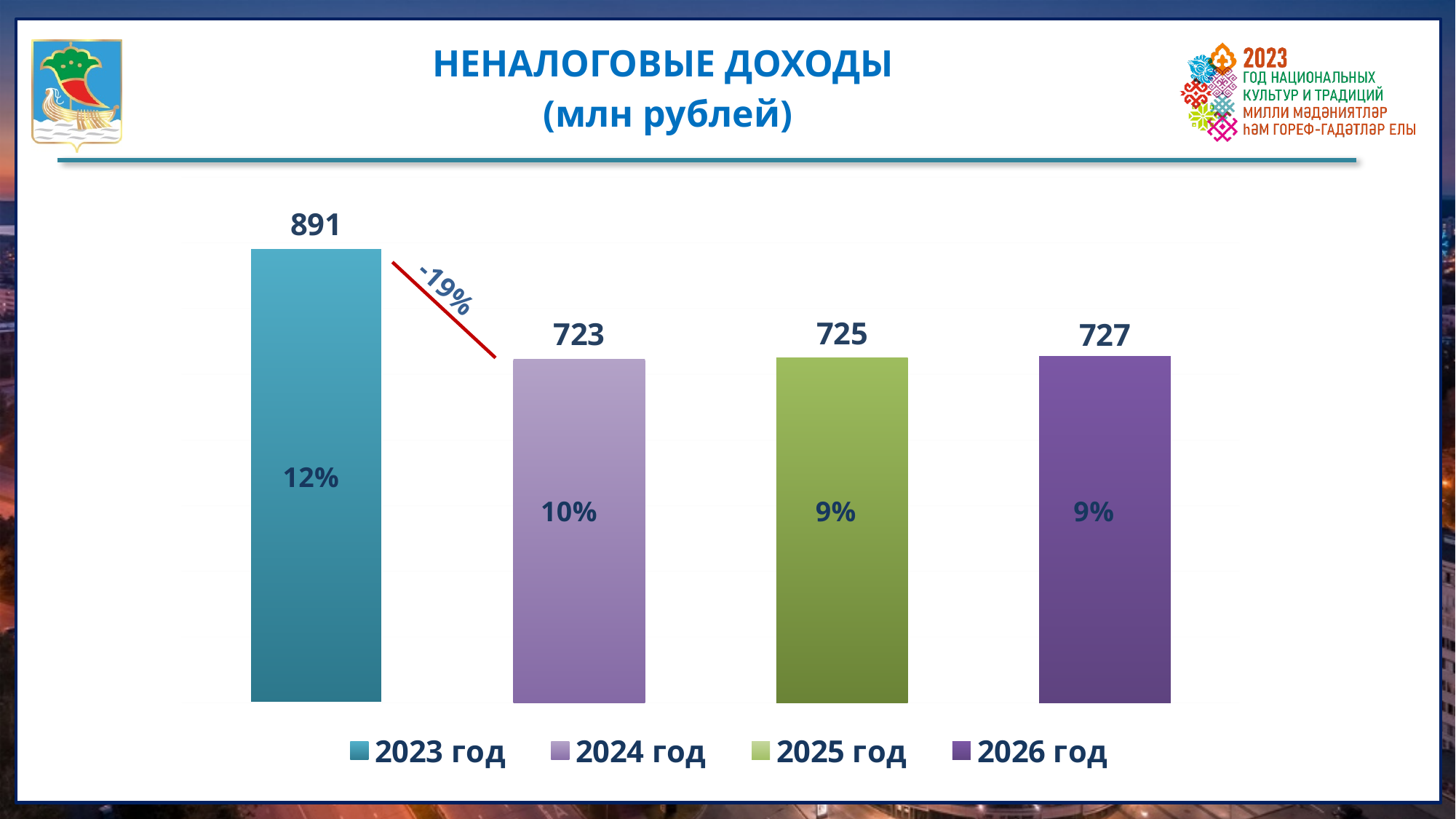
Which year has the lowest value? 2024 год What kind of chart is shown on the slide? Bar chart What percentage is shown inside the bar for 2025 год? 9% What is the value for 2023 год? 891 What is the value for 2024 год? 723 What is the difference between the values for 2026 год and 2025 год? 2 What is the value for 2026 год? 727 Which year has the highest value? 2023 год How many bars are shown in the chart? 4 What is the difference between the values for 2023 год and 2024 год? 168 What percentage change is shown by the red arrow between 2023 год and 2024 год? -19% What percentage is shown inside the bar for 2023 год? 12%